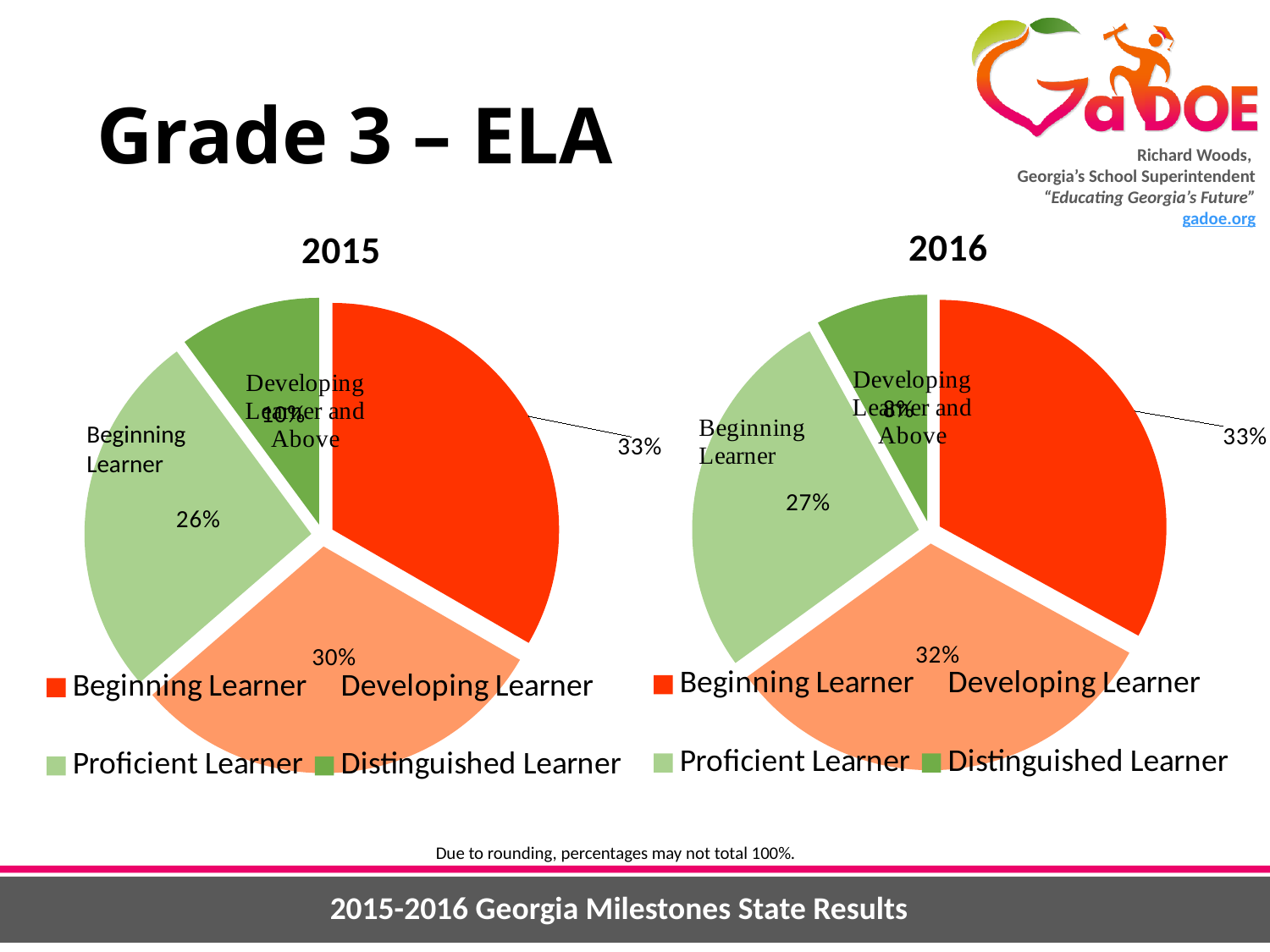
In the 2016 pie chart, what percentage of students were Developing Learners? 32% Was the Developing Learner percentage higher in the 2015 chart or the 2016 chart? 2016 In the 2015 pie chart, what percentage of students were Proficient Learners? 26% In the 2015 pie chart, what is the difference in percentage points between Beginning Learners and Proficient Learners? 7 percentage points In the 2015 pie chart, which category has the largest slice? Beginning Learner In the 2016 pie chart, what percentage of students were Proficient Learners? 27% In the 2015 pie chart, what percentage of students were Developing Learners? 30% In the 2016 pie chart, what percentage of students were Beginning Learners? 33% What type of chart is used to show the 2015 and 2016 results? Pie chart In the 2016 pie chart, which category has the smallest slice? Distinguished Learner In the 2015 pie chart, what percentage of students were Beginning Learners? 33% How many categories does the legend of the 2016 pie chart list? 4